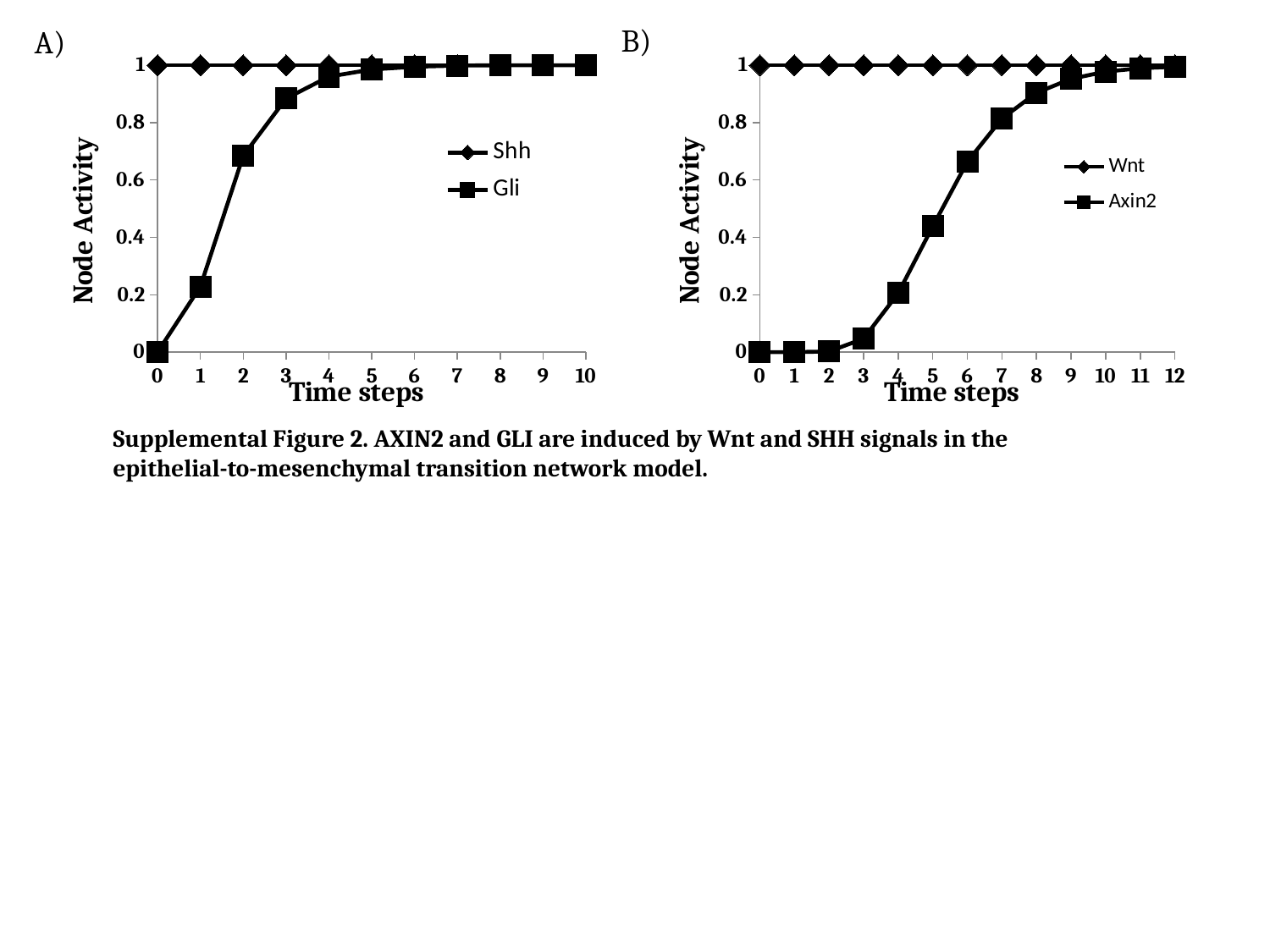
In chart A, what is the value of Gli at time step 0? 0 In chart A, is the value of Gli at time step 1 greater or less than 0.4? less In chart A, how many series does the legend list? 2 What type of chart is chart A? line chart In chart B, which two series are listed in the legend? Wnt and Axin2 In chart A, what is the value of Shh at time step 5? 1 In chart B, is the value of Axin2 at time step 6 greater or less than 0.6? greater In chart A, is the value of Gli at time step 2 greater or less than 0.6? greater In chart B, how many time steps are shown on the x axis? 13 In chart A, does the Gli series rise or fall along the x axis? rise In chart B, which series has the larger value at time step 4, Wnt or Axin2? Wnt